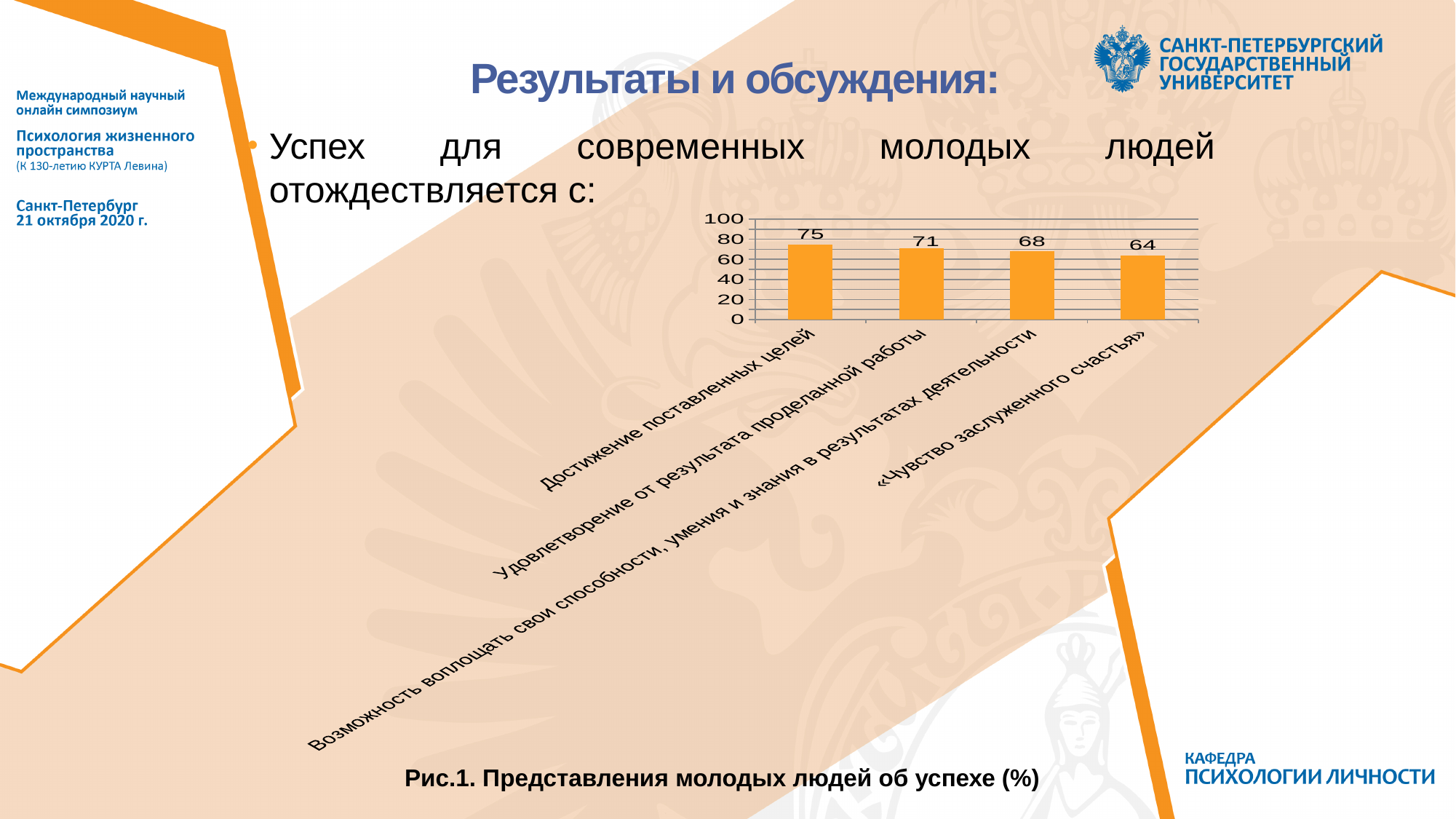
Which category has the highest value? Достижение поставленных целей Which is larger: the value for «Удовлетворение от результата проделанной работы» or for «Возможность воплощать свои способности, умения и знания в результатах деятельности»? Удовлетворение от результата проделанной работы Which category has the lowest value? «Чувство заслуженного счастья» What is the value for «Достижение поставленных целей»? 75 What is the value for «Возможность воплощать свои способности, умения и знания в результатах деятельности»? 68 What is the value for «Чувство заслуженного счастья»? 64 What is the difference between the values for «Достижение поставленных целей» and «Чувство заслуженного счастья»? 11 Do the values rise or fall from left to right across the categories? fall What is the value for «Удовлетворение от результата проделанной работы»? 71 Is the value for «Чувство заслуженного счастья» greater or less than 80? less How many categories are shown in the chart? 4 What kind of chart is shown on the slide? bar chart